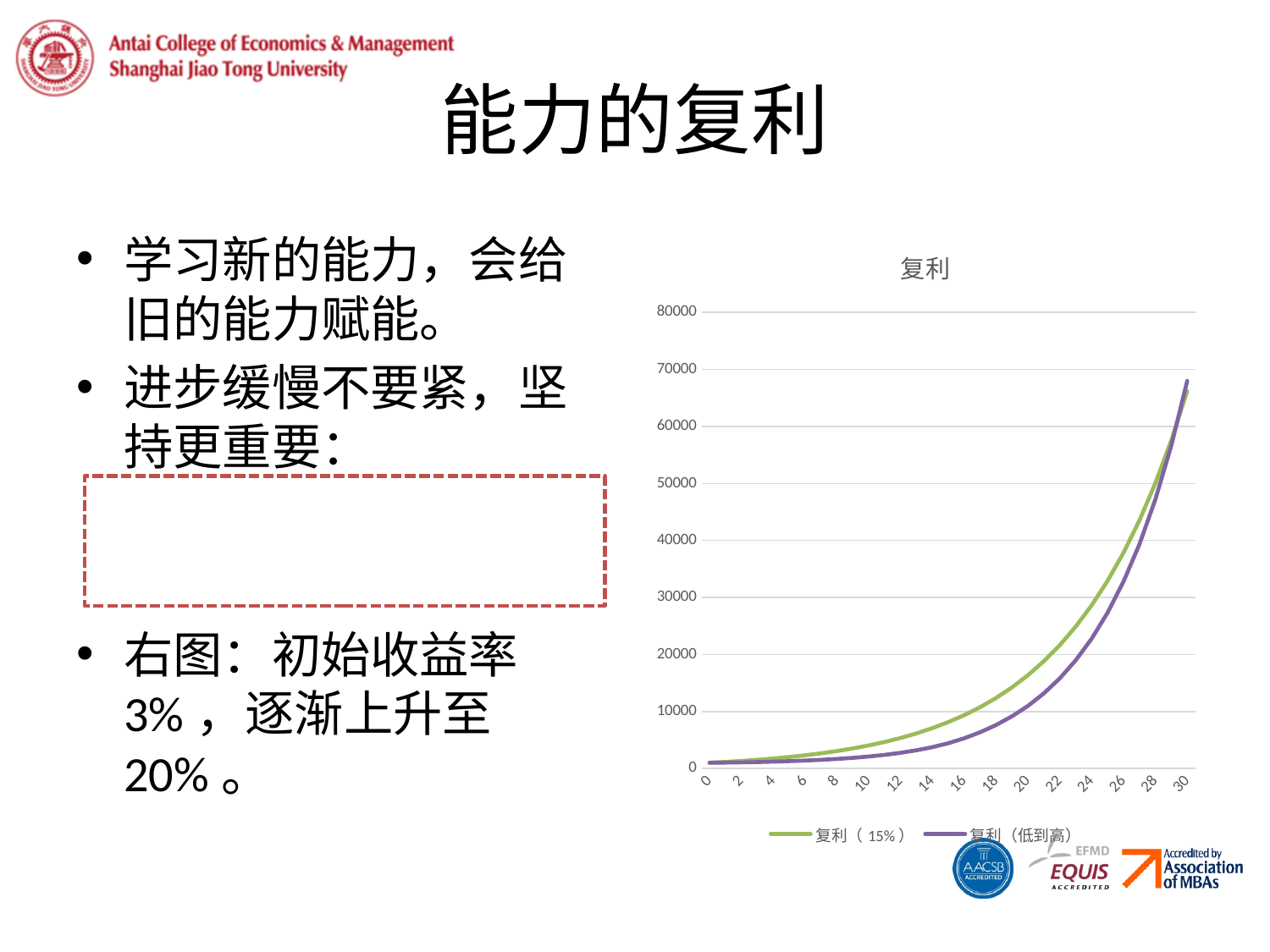
Is the value of the 复利（15%） series at x = 26 greater or less than 30000? greater How many series does the chart legend list? 2 Is the value of the 复利（15%） series at x = 20 greater or less than 10000? greater What is the title of the chart? 复利 Is the value of the 复利（低到高） series at x = 30 greater or less than 60000? greater Do the values of the 复利（15%） series rise or fall as the x axis increases? rise What is the highest value labelled on the y axis? 80000 Which series is drawn in green? 复利（15%） What kind of chart is shown on the slide? line chart At x = 20, which series has the larger value, 复利（15%） or 复利（低到高）? 复利（15%）